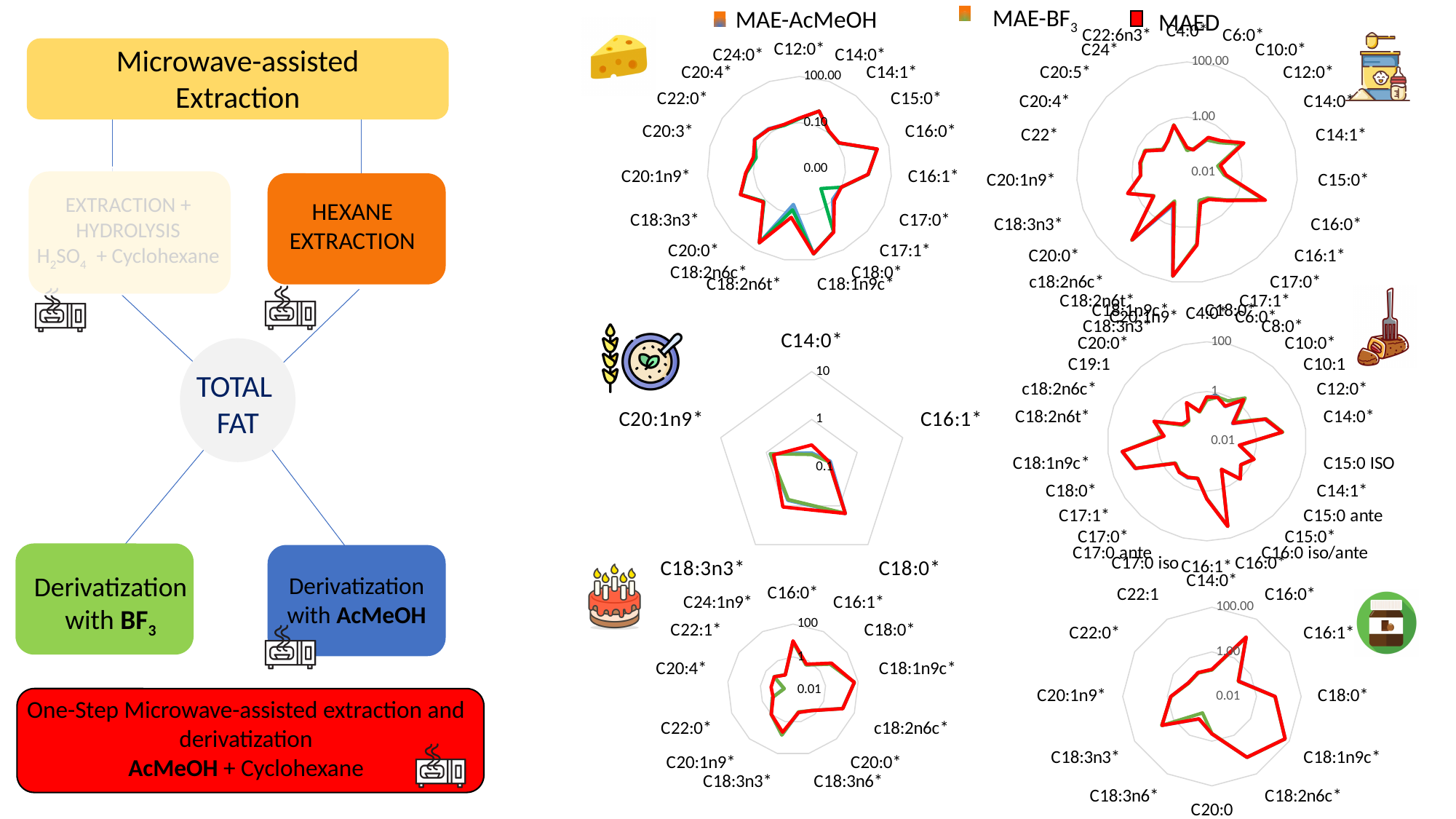
Which series in the legend is drawn in red? MAED How many radar charts are shown on the right side of the slide? 6 In the radar chart with the cereal bowl icon (middle left), is the value for C14:0 greater or less than 10? less In the radar chart with the cereal bowl icon (middle left), what is the highest axis tick value shown? 10 What are the three series named in the legend at the top of the slide? MAE-AcMeOH, MAE-BF3, MAED In the radar chart with the cake icon (bottom left), is the value for C16:0 greater or less than 100? less What kind of chart is used for the six charts on the right side of the slide? Radar chart In the radar chart with the cereal bowl icon (middle left), how many categories are plotted? 5 How many series does the legend at the top of the slide list? 3 In the radar chart with the cheese icon (top left), is the value for C18:1n9c greater or less than 100.00? less